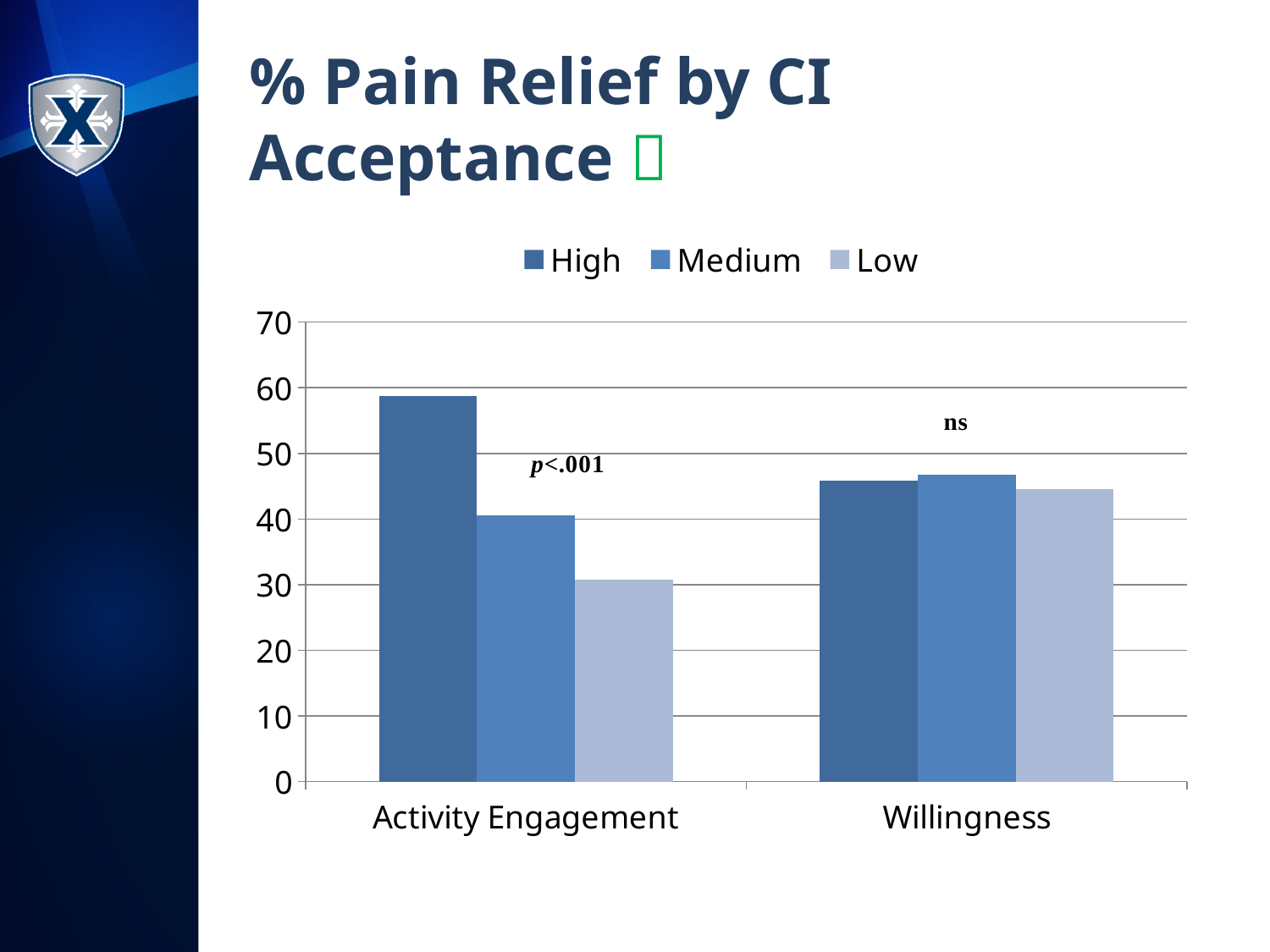
Is the High value for Activity Engagement greater or less than 50? greater Which is larger: the High value for Activity Engagement or the High value for Willingness? Activity Engagement Is the Low value for Activity Engagement greater or less than 40? less How many series does the legend list? 3 Which series has the lowest value for Activity Engagement? Low What is the title of the chart on the slide? % Pain Relief by CI Acceptance What kind of chart is shown on the slide? bar chart Which series has the highest value for Activity Engagement? High Which is larger: the Low value for Activity Engagement or the Low value for Willingness? Willingness Is the Low value for Willingness greater or less than 40? greater How many categories are shown on the x axis? 2